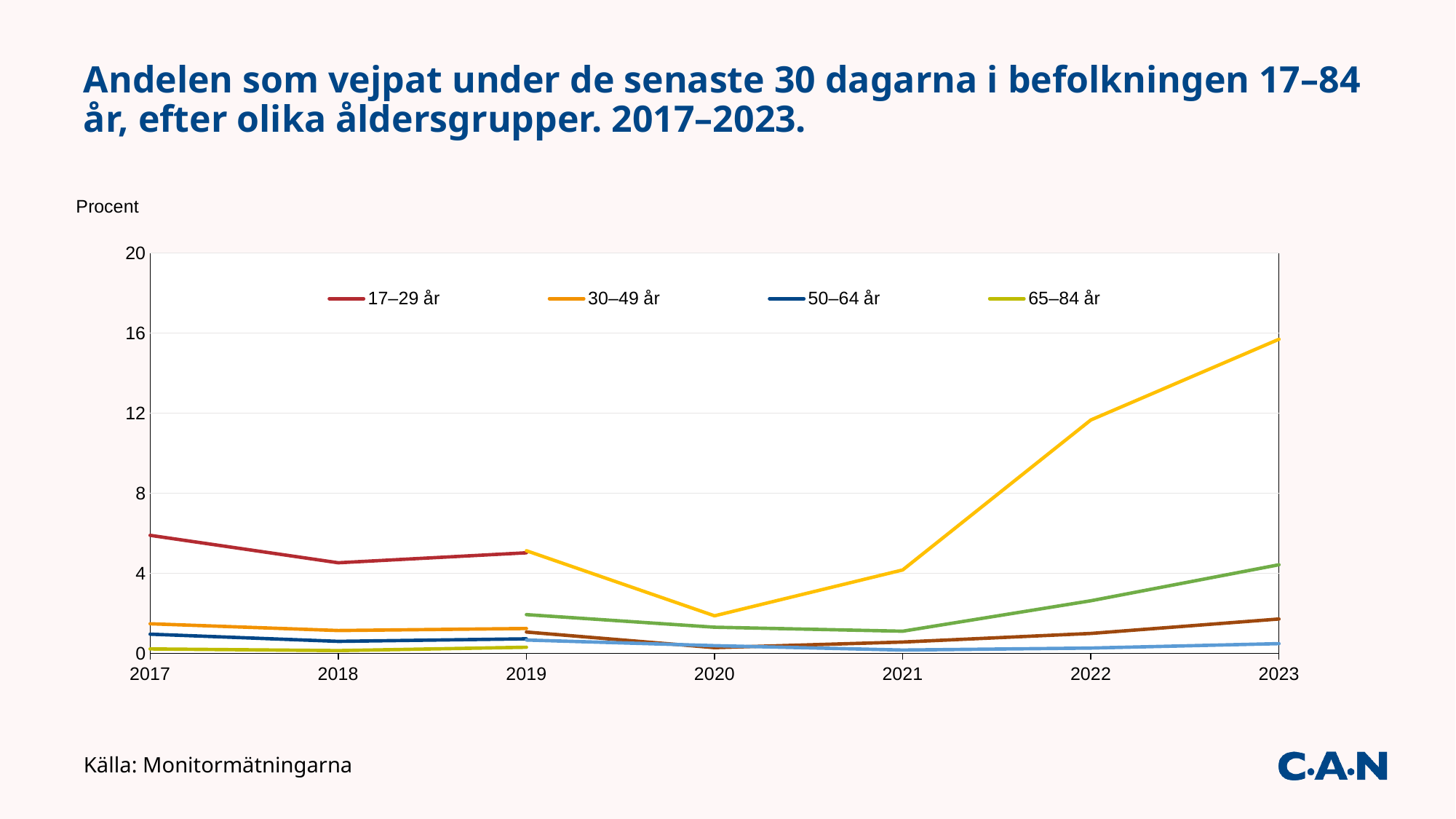
Is the value for 17–29 år in 2017 greater or less than 4? greater How many series does the legend list? 4 Does the topmost line rise or fall from 2020 to 2023? rise Does the 17–29 år line rise or fall from 2017 to 2018? fall What kind of chart is shown on the slide? Line chart Which is larger in 2017, the value for 17–29 år or the value for 30–49 år? 17–29 år What label is shown above the y axis of the chart? Procent Which age group has the highest value in 2017? 17–29 år Is the value for 30–49 år in 2017 greater or less than 4? less Is the value for 65–84 år in 2019 greater or less than 4? less How many years are shown along the x axis? 7